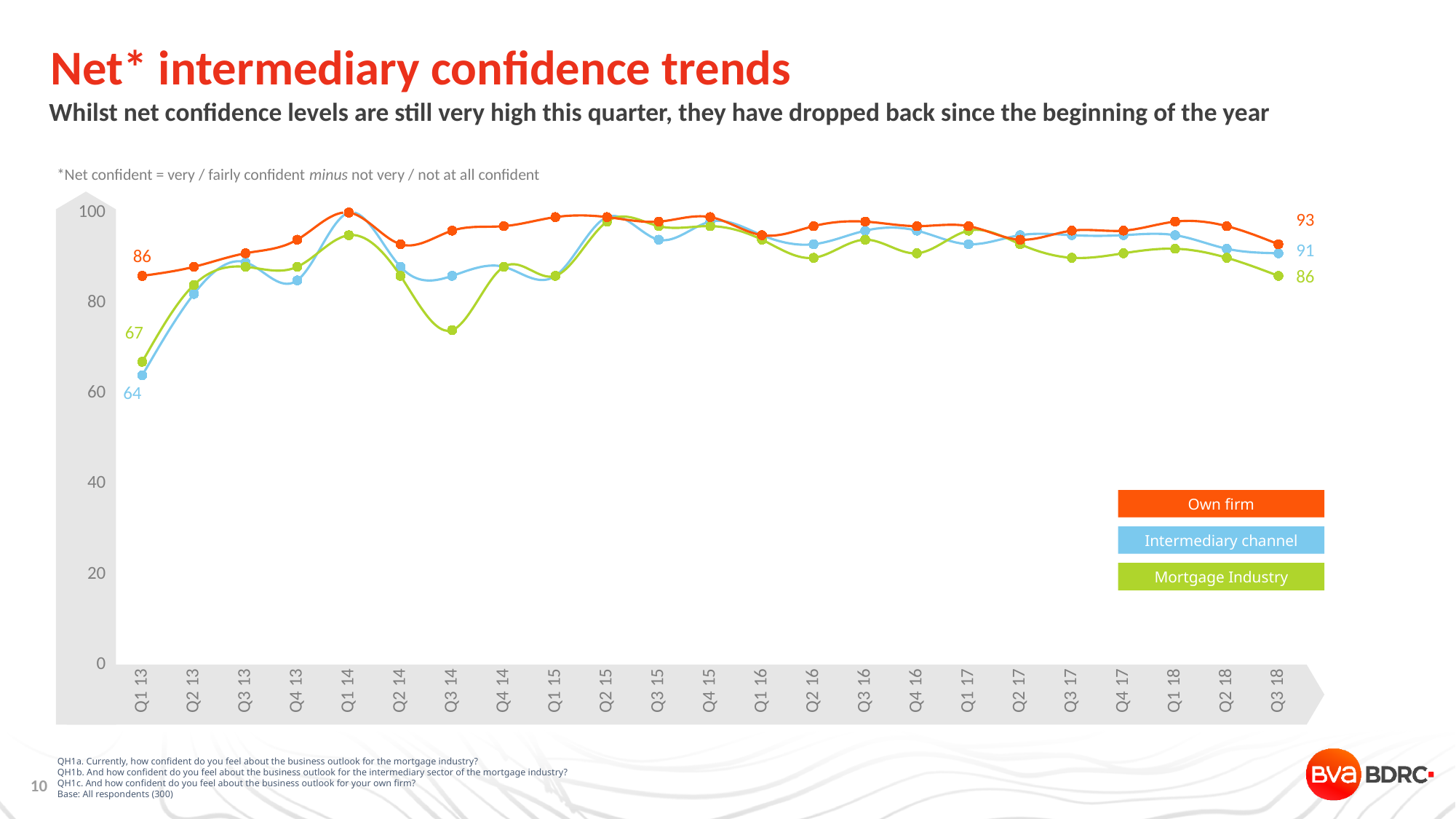
Which is larger in Q1 13: the Mortgage Industry value or the Intermediary channel value? Mortgage Industry Which series has the lowest value in Q1 13? Intermediary channel What is the Intermediary channel value in Q1 13? 64 How many quarters are plotted along the x axis? 23 How many series does the legend list? 3 Which series is shown in orange in the legend? Own firm Is the Mortgage Industry value in Q3 14 greater or less than 80? less What type of chart is shown on the slide? line chart What is the Own firm value in Q1 13? 86 What is the difference between the Own firm and Intermediary channel values in Q3 18? 2 What is the Own firm value in Q3 18? 93 What is the Mortgage Industry value in Q3 18? 86